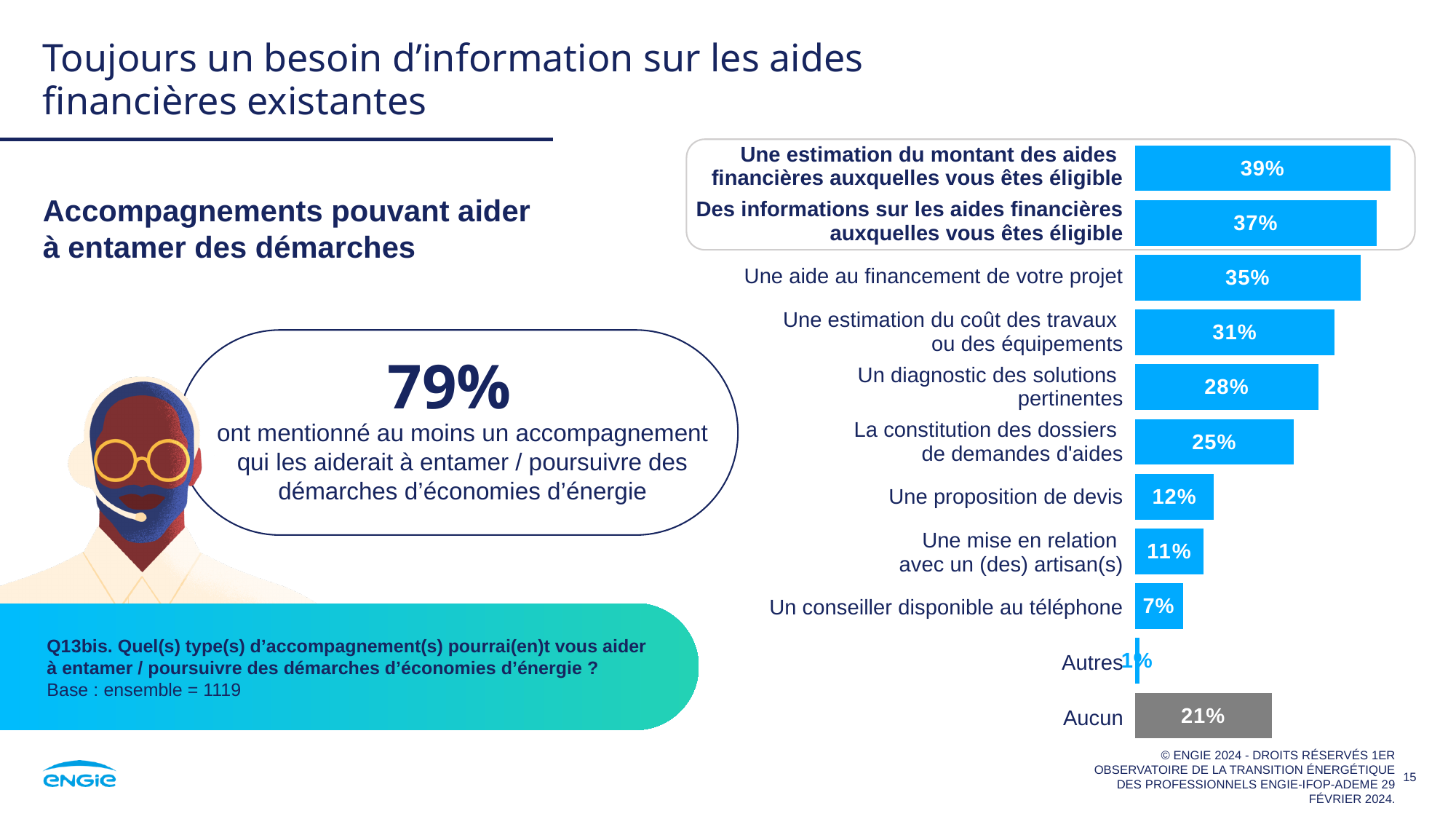
Which category has the lowest value in the chart? Autres What percentage of respondents mentioned "Une estimation du montant des aides financières auxquelles vous êtes éligible"? 39% What is the value shown for "Un conseiller disponible au téléphone"? 7% What type of chart is shown on the slide? Bar chart Which is larger: the value for "Une proposition de devis" or the value for "Une mise en relation avec un (des) artisan(s)"? Une proposition de devis What is the value shown for "Une aide au financement de votre projet"? 35% What is the difference between the values for "Une estimation du coût des travaux ou des équipements" and "Un diagnostic des solutions pertinentes"? 3 percentage points Which category has the highest value in the chart? Une estimation du montant des aides financières auxquelles vous êtes éligible Which bar in the chart is coloured grey rather than blue? Aucun What is the value shown for "La constitution des dossiers de demandes d'aides"? 25% How many categories are shown in the bar chart? 11 What is the value shown for "Aucun"? 21%